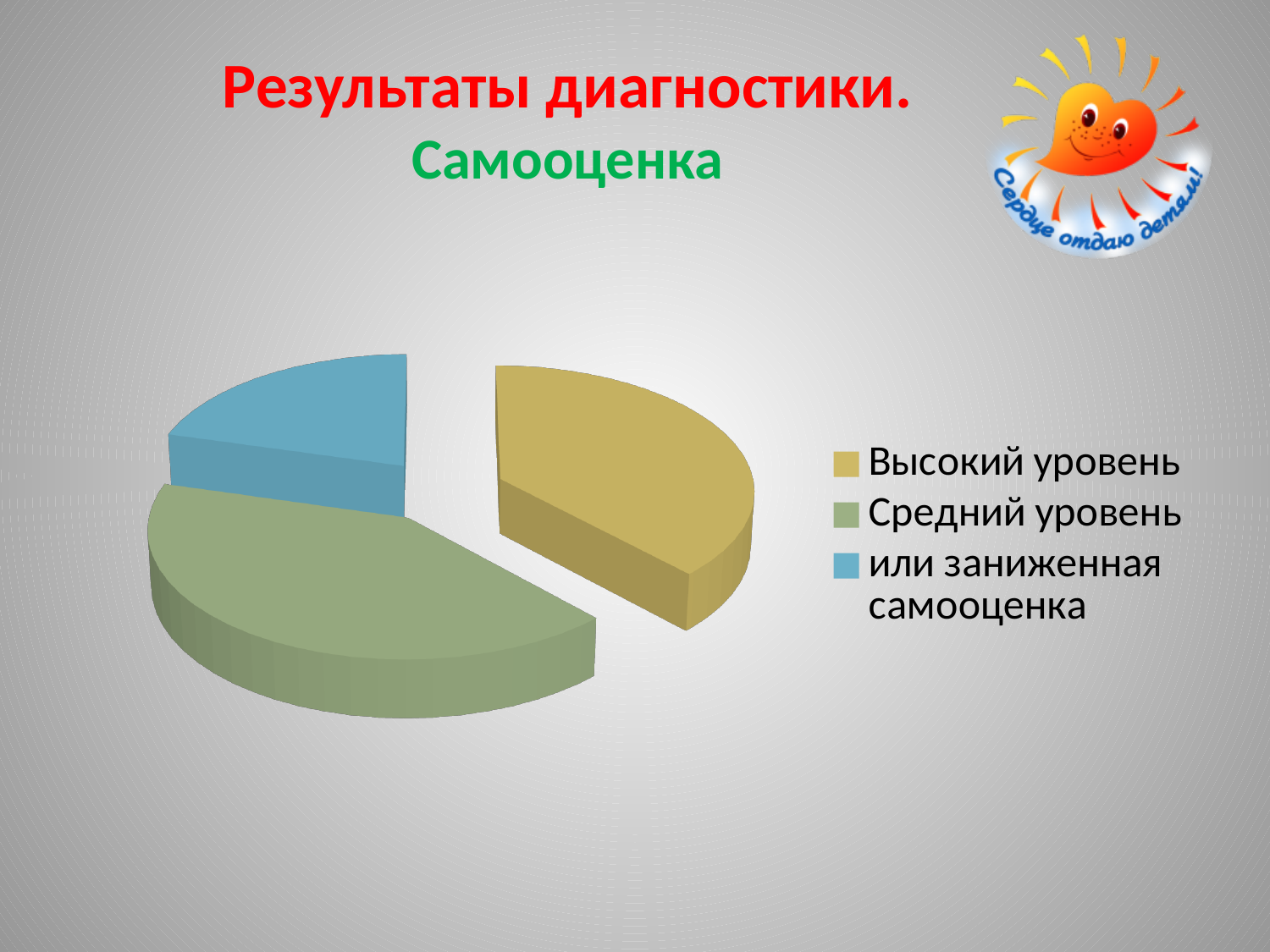
How many slices does the pie chart have? 3 Which category has the largest slice in the pie chart? Средний уровень What colour is the slice for Высокий уровень? Yellow What is the title of the slide containing the pie chart? Результаты диагностики. Самооценка Which category has the smallest slice in the pie chart? или заниженная самооценка How many entries does the legend of the pie chart list? 3 Which slice is larger, Высокий уровень or или заниженная самооценка? Высокий уровень What kind of chart is shown on the slide? Pie chart Which slice is larger, Средний уровень or Высокий уровень? Средний уровень